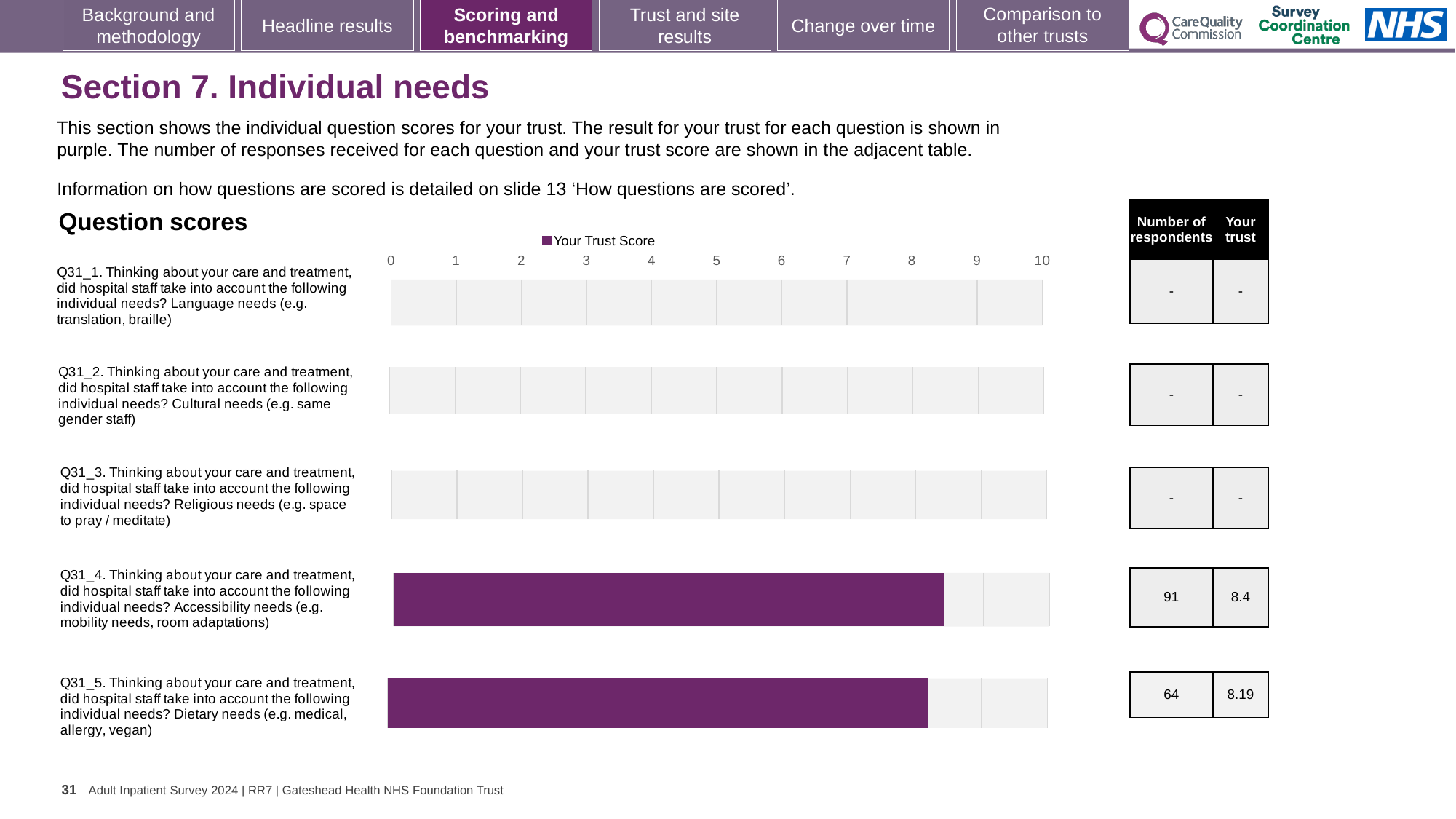
What is the difference between the trust scores for Q31_4 (Accessibility needs) and Q31_5 (Dietary needs)? 0.21 What is the name of the series shown in the legend of the question score charts? Your Trust Score Which question has the higher trust score, Q31_4 (Accessibility needs) or Q31_5 (Dietary needs)? Q31_4 How many respondents answered Q31_5 (Dietary needs)? 64 How many respondents answered Q31_4 (Accessibility needs)? 91 Is the trust score for Q31_5 (Dietary needs) greater or less than 9? less Is the trust score for Q31_4 (Accessibility needs) greater or less than 8? greater What is the trust score for Q31_5 (Dietary needs)? 8.19 What is the trust score for Q31_4 (Accessibility needs)? 8.4 How many series does the legend above the question score charts list? 1 What is the maximum value shown on the x axis of the question score charts? 10 What type of chart is used to show the question scores on this slide? Bar chart